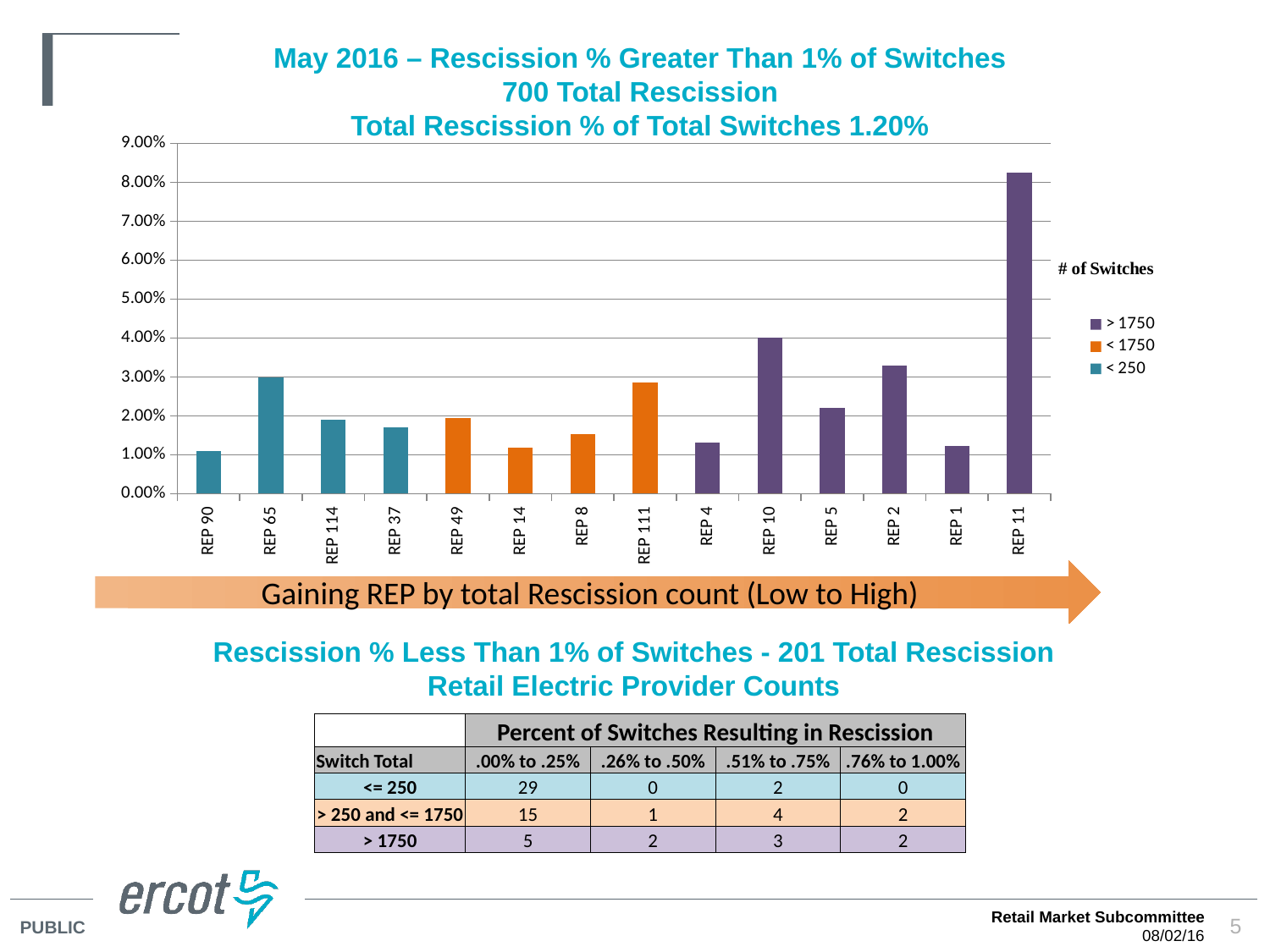
Is the value for REP 10 greater or less than 3.00%? greater How many series does the chart legend list? 3 Is the value for REP 11 greater or less than 7.00%? greater Which REP has the highest rescission percentage in the chart? REP 11 Is the value for REP 65 greater or less than 2.00%? greater What kind of chart is shown on the slide? bar chart Which legend series does the bar for REP 49 belong to? < 1750 How many REPs are plotted along the x axis of the chart? 14 Which has the larger rescission percentage, REP 111 or REP 49? REP 111 What is the title of the chart legend? # of Switches Which has the larger rescission percentage, REP 10 or REP 2? REP 10